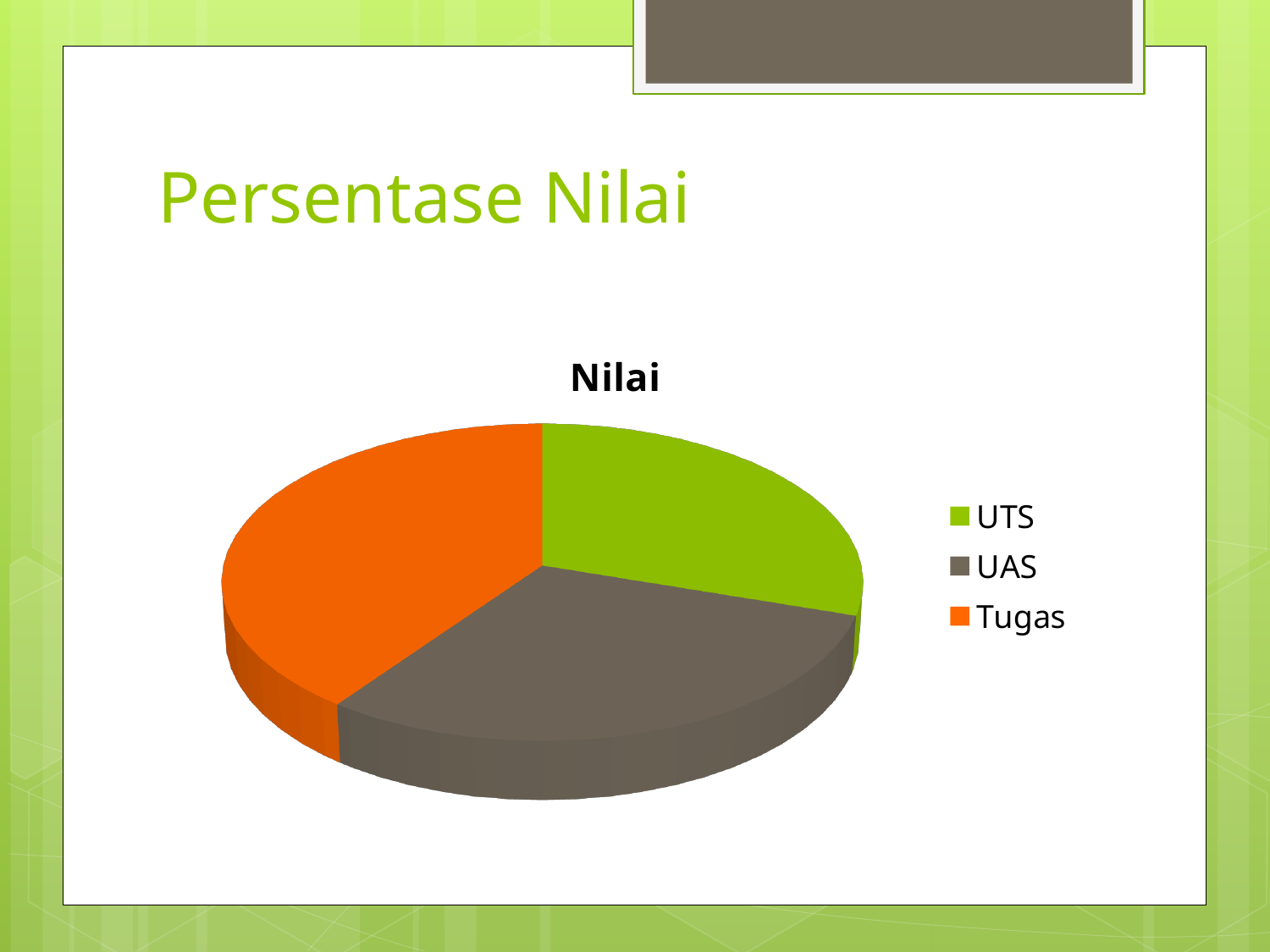
How many slices does the pie chart have? 3 Which slice is larger, UTS or Tugas? Tugas What kind of chart is shown on the slide? pie chart How many entries does the legend list? 3 Which colour represents Tugas in the pie chart? orange What is the title of the chart? Nilai Which category is shown in green? UTS